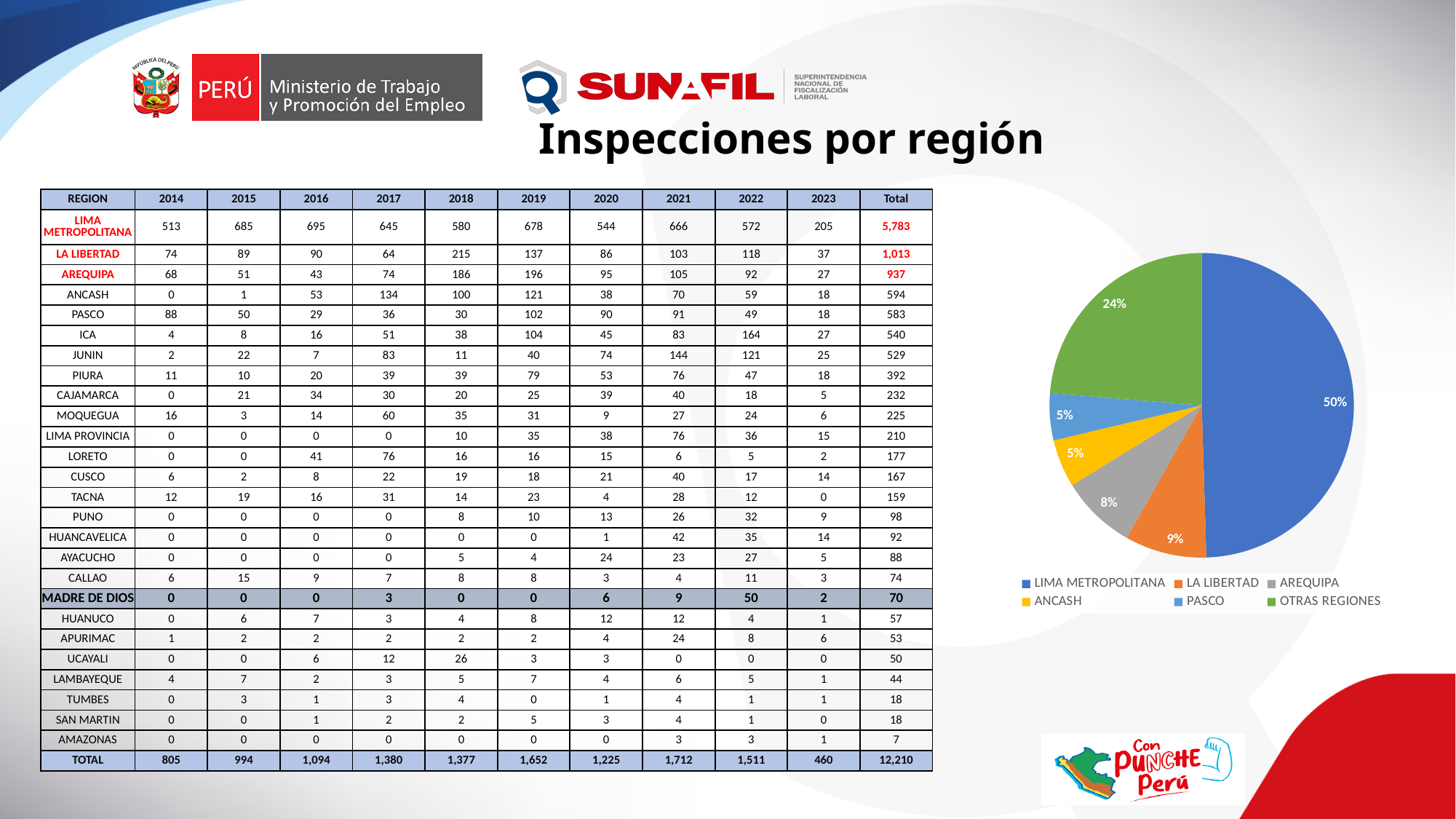
In the pie chart, what share does LIMA METROPOLITANA have? 50% In the pie chart, what is the difference between the share for LIMA METROPOLITANA and the share for OTRAS REGIONES? 26% In the pie chart, what share does ANCASH have? 5% How many slices does the pie chart have? 6 What kind of chart is shown on the slide? pie chart In the pie chart, which is larger, the share for LA LIBERTAD or the share for AREQUIPA? LA LIBERTAD How many entries does the pie chart legend list? 6 What colour is the LIMA METROPOLITANA slice in the pie chart? blue In the pie chart, what share does AREQUIPA have? 8% Which slice of the pie chart is the largest? LIMA METROPOLITANA